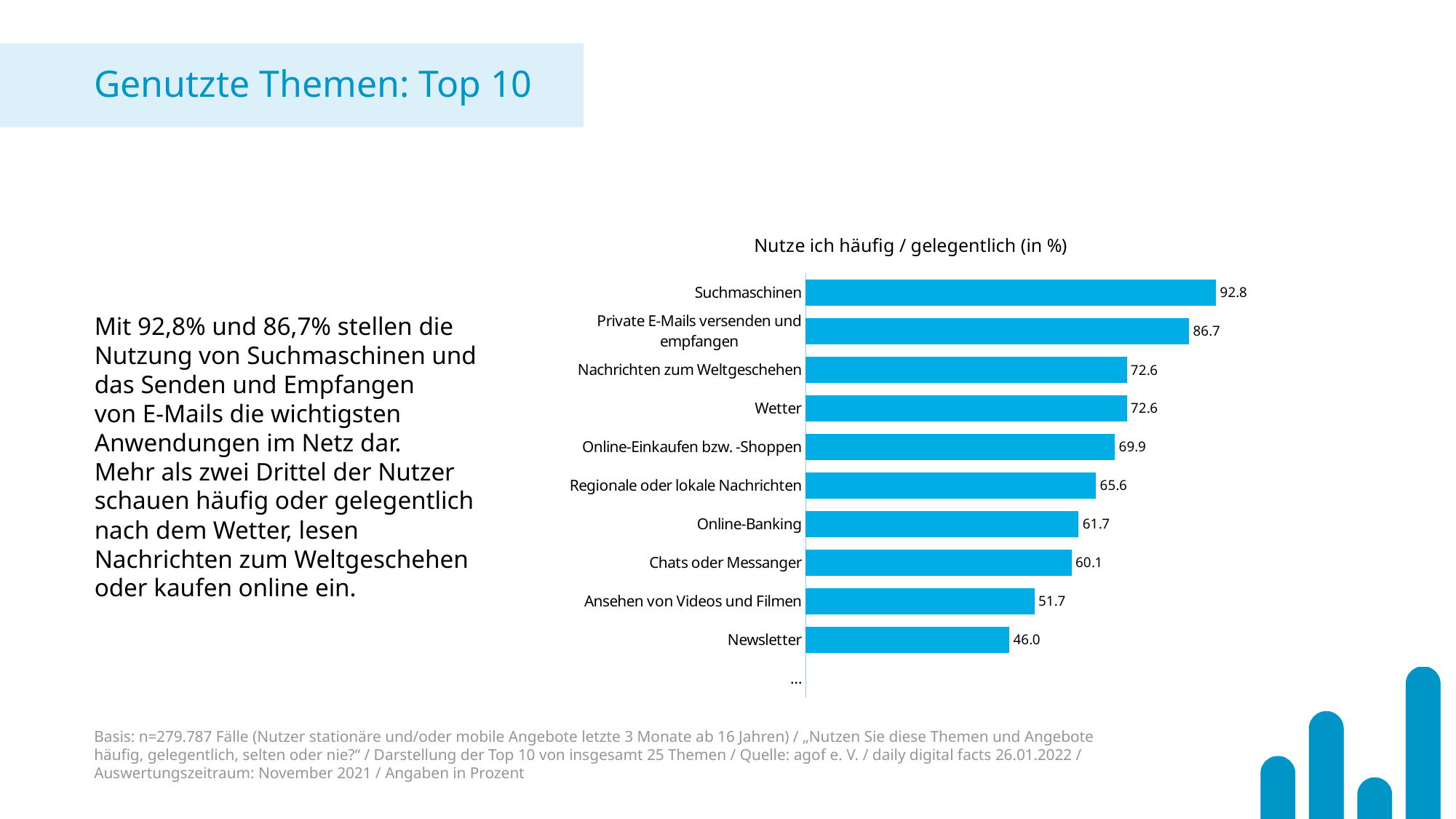
What kind of chart is shown on the slide? Bar chart How many bars with values are plotted in the chart? 10 What is the value for Online-Banking? 61.7 What is the difference between the values for Chats oder Messanger and Newsletter? 14.1 Which category has the lowest value among the bars shown? Newsletter Which is larger, the value for Online-Einkaufen bzw. -Shoppen or the value for Regionale oder lokale Nachrichten? Online-Einkaufen bzw. -Shoppen What is the difference between the values for Suchmaschinen and Private E-Mails versenden und empfangen? 6.1 What is the value for Suchmaschinen? 92.8 What is the title of the chart? Nutze ich häufig / gelegentlich (in %) What is the value for Ansehen von Videos und Filmen? 51.7 What is the value for Newsletter? 46.0 Which category has the highest value? Suchmaschinen